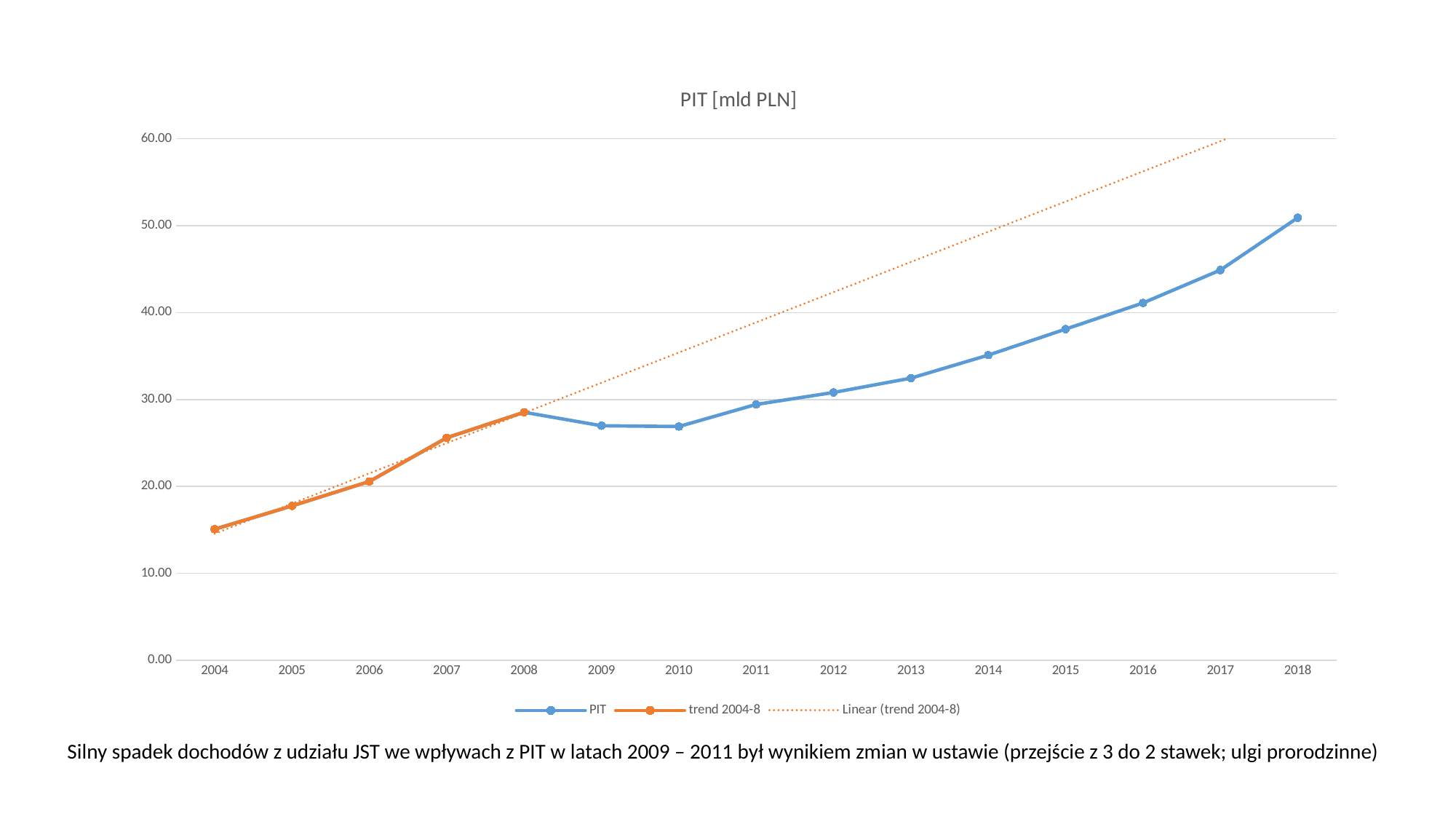
Which year has the larger PIT value, 2014 or 2017? 2017 Is the PIT value for 2004 greater or less than 20.00? less Is the PIT value for 2010 greater or less than 30.00? less Is the PIT value for 2018 greater or less than 40.00? greater What kind of chart is shown on the slide? line chart How many years are shown on the x axis? 15 Which year has the highest PIT value? 2018 What is the title of the chart? PIT [mld PLN] Which year has the lowest PIT value? 2004 Does the PIT series rise or fall between 2008 and 2009? fall How many series does the legend list? 3